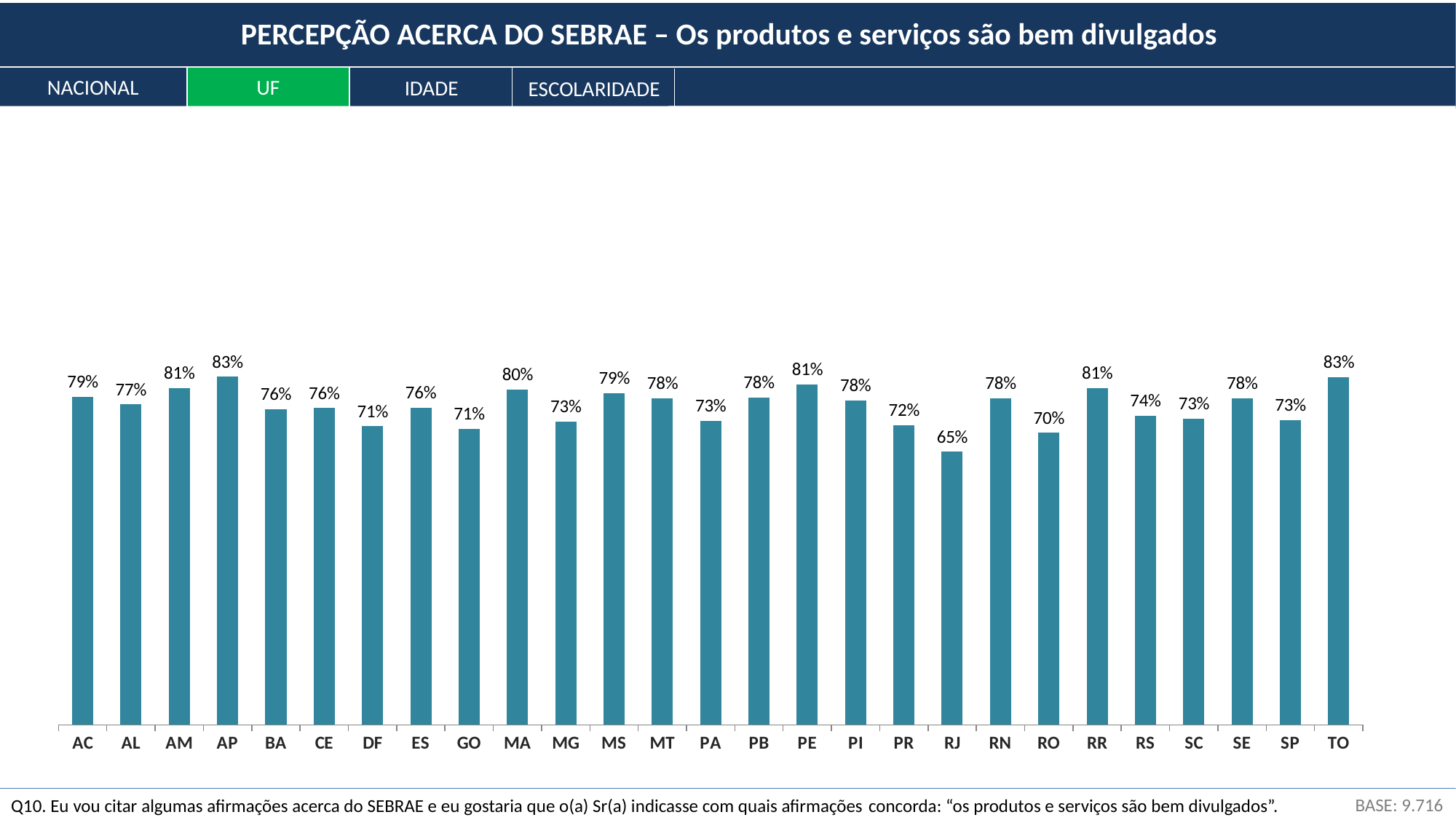
What is the difference between the values for PE and PR? 9% What is the value for DF? 71% Which is larger, the value for MS or the value for RO? MS What is the value for MA? 80% How many states are shown on the x axis? 27 What is the value for RR? 81% What is the value for RJ? 65% Which two states share the highest value of 83%? AP and TO What is the difference between the values for AP and RJ? 18% Which state has the lowest value? RJ Which tab is highlighted in green below the title? UF What kind of chart is shown on the slide? Bar chart